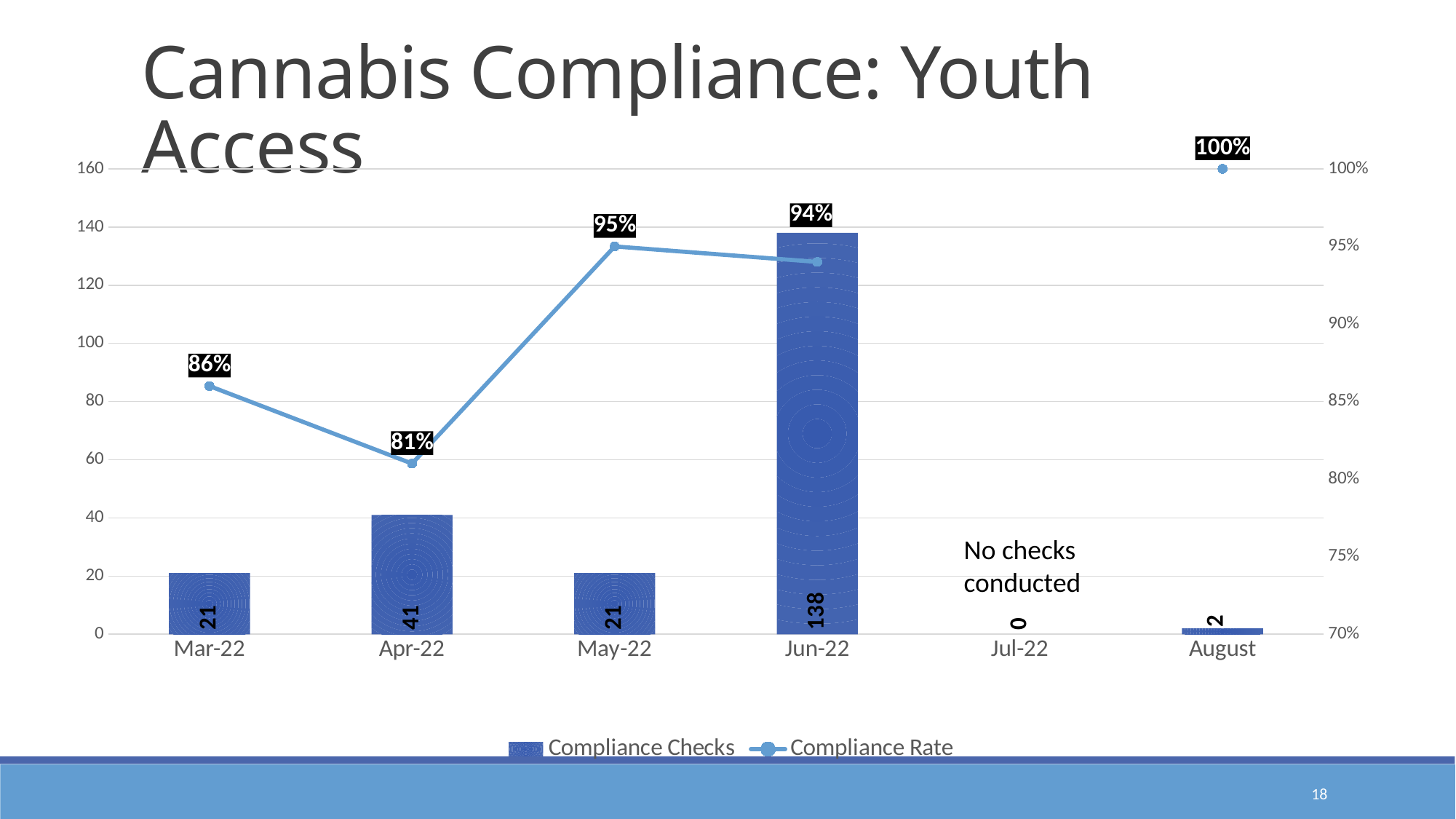
What is the difference in compliance checks between Jun-22 and Apr-22? 97 How many series does the legend list? 2 How many months are shown on the x axis? 6 What text is shown above the Jul-22 category instead of a bar? No checks conducted What was the compliance rate in August? 100% Which month had the highest number of compliance checks? Jun-22 Which month had more compliance checks, Apr-22 or May-22? Apr-22 What kind of chart is used for the Compliance Checks series? Bar chart What was the compliance rate in Apr-22? 81% Is the number of compliance checks in Jun-22 greater or less than 120? greater How many compliance checks were conducted in Jun-22? 138 Which month had the lowest compliance rate among the months with a rate shown? Apr-22